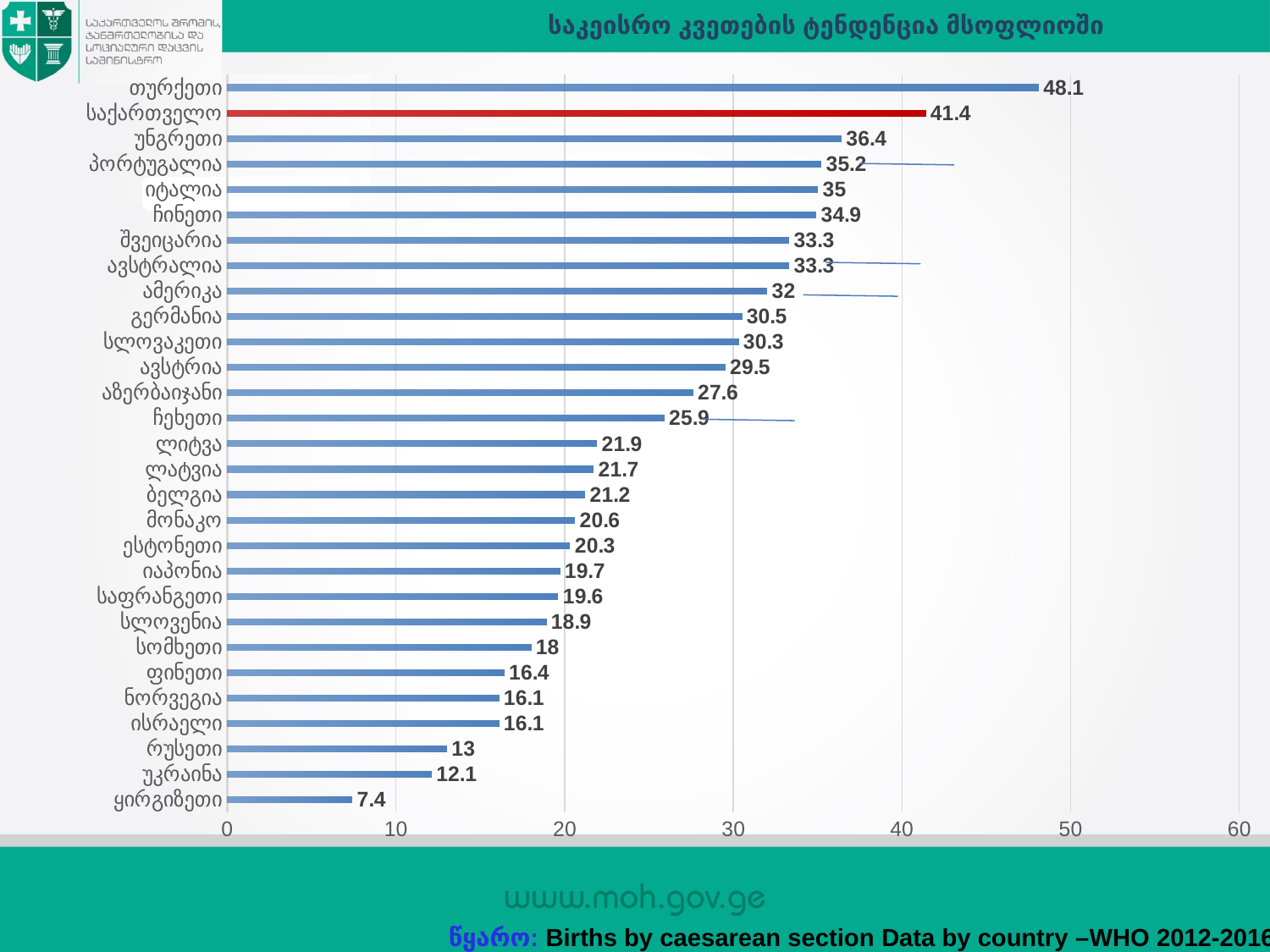
What is the difference between the values for თურქეთი and საქართველო? 6.7 Which bar is highlighted in red? საქართველო Which has a larger value, გერმანია or ავსტრია? გერმანია What is the value for ყირგიზეთი? 7.4 Is the value for ამერიკა greater or less than 30? greater What is the value for საქართველო? 41.4 Which country has the highest value? თურქეთი Which country has the lowest value? ყირგიზეთი What is the difference between the values for უკრაინა and რუსეთი? 0.9 What is the value for ჩინეთი? 34.9 What kind of chart is shown on the slide? bar chart How many countries are shown in the chart? 29